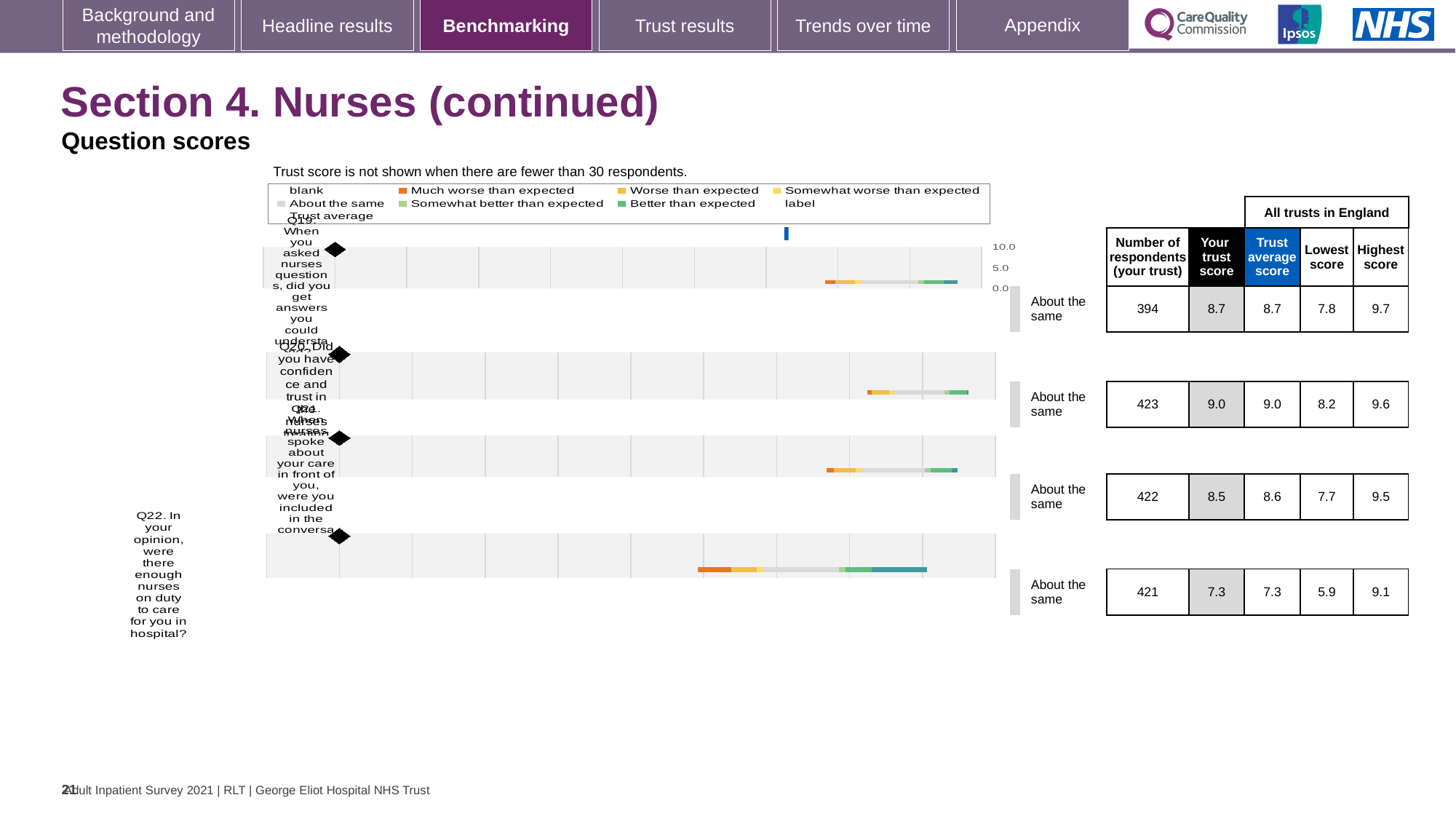
How many respondents from the trust answered Q20 (confidence and trust in nurses)? 423 What is the trust average score for Q21 (nurses speaking about your care in front of you)? 8.6 What benchmark category label is shown next to each of the four questions? About the same Which has the larger 'Your trust score': Q19 or Q21? Q19 What kind of chart is used to show the question scores on this slide? bar chart What is the lowest score across all trusts in England for Q22? 5.9 Which question has the highest 'Your trust score'? Q20 Which question has the lowest 'Your trust score'? Q22 What is the difference between the highest score (9.6) and the lowest score (8.2) for Q20? 1.4 What is the 'Your trust score' for Q22 (enough nurses on duty)? 7.3 How many questions (Q19 to Q22) are plotted in the chart? 4 Is the trust score for Q22 greater or less than 5.0? greater